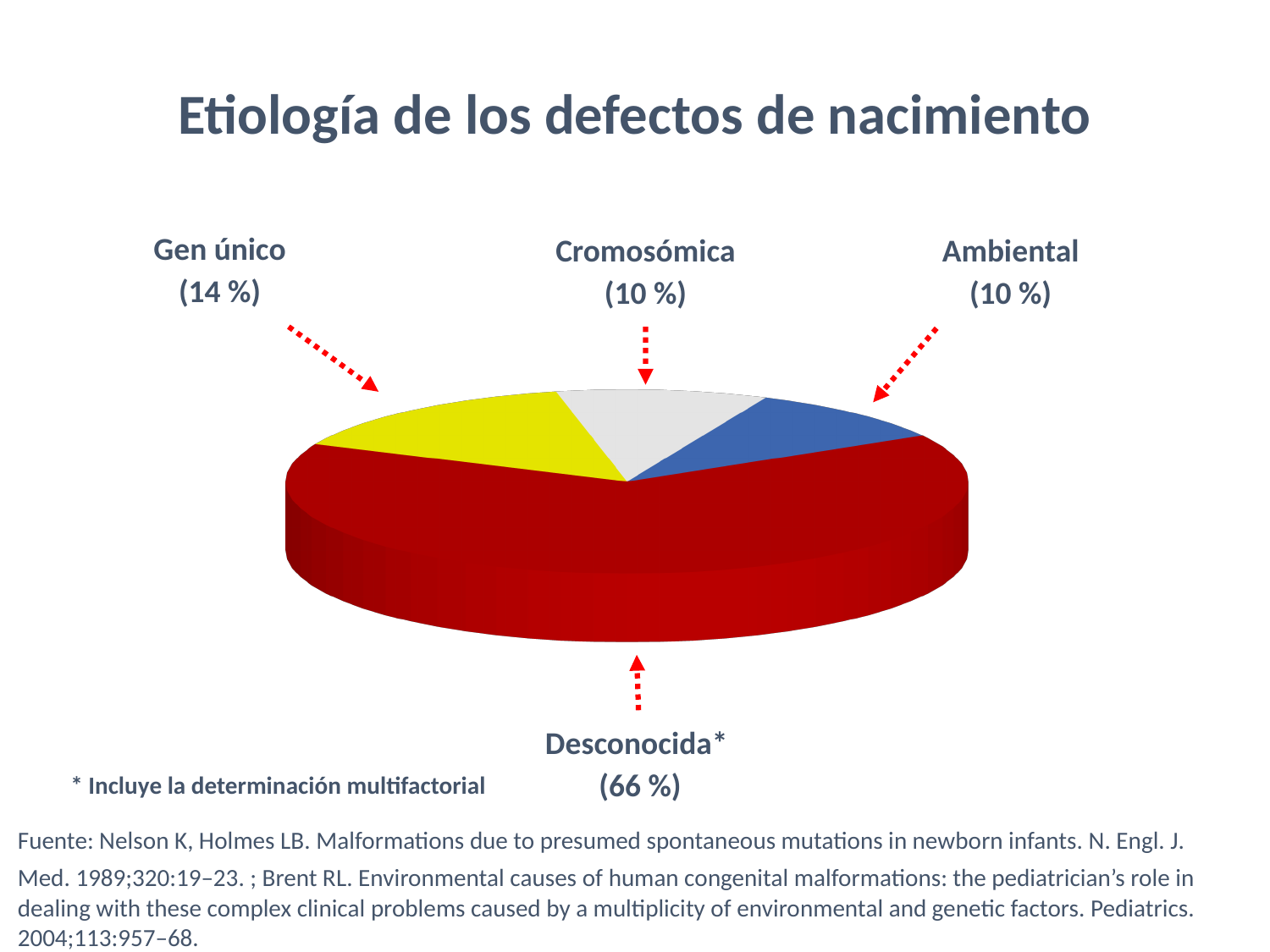
What is the difference between the Desconocida* share and the Gen único share? 52 % What is the value shown for Gen único? 14 % What colour is the Desconocida* slice? Red What share of birth defects does the Desconocida* slice represent? 66 % How many categories are shown in the pie chart? 4 What is the value shown for Cromosómica? 10 % What is the difference between the Gen único share and the Ambiental share? 4 % Which is larger, Gen único or Cromosómica? Gen único Which category has the largest slice of the pie? Desconocida* What kind of chart is shown on the slide? Pie chart What is the value shown for Ambiental? 10 % What is the title of the chart? Etiología de los defectos de nacimiento